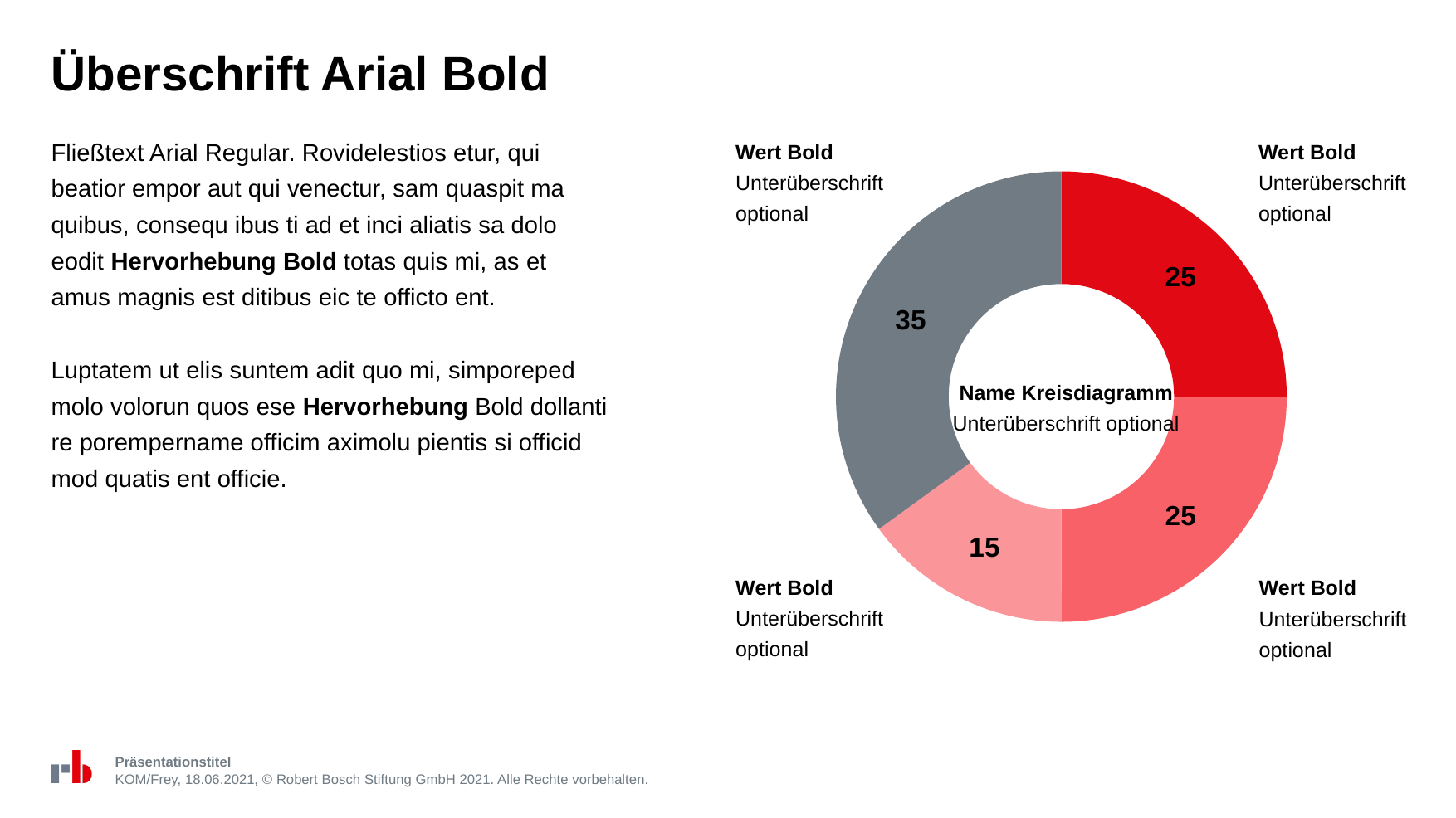
What share of the donut chart does the grey slice represent? 35% How many slices does the donut chart have? 4 What is the value of the grey slice of the donut chart? 35 What is the value of the dark red slice at the top right of the donut chart? 25 What is the total of all slice values in the donut chart? 100 What is the difference between the grey slice and the light pink slice in the donut chart? 20 What kind of chart is shown on the slide? Donut (pie) chart What is the value of the light pink slice at the bottom left of the donut chart? 15 Which slice of the donut chart has the smallest value? The light pink slice (15) Which slice of the donut chart has the largest value? The grey slice (35) What title is printed in the centre of the donut chart? Name Kreisdiagramm Is the grey slice or the dark red slice larger in the donut chart? The grey slice